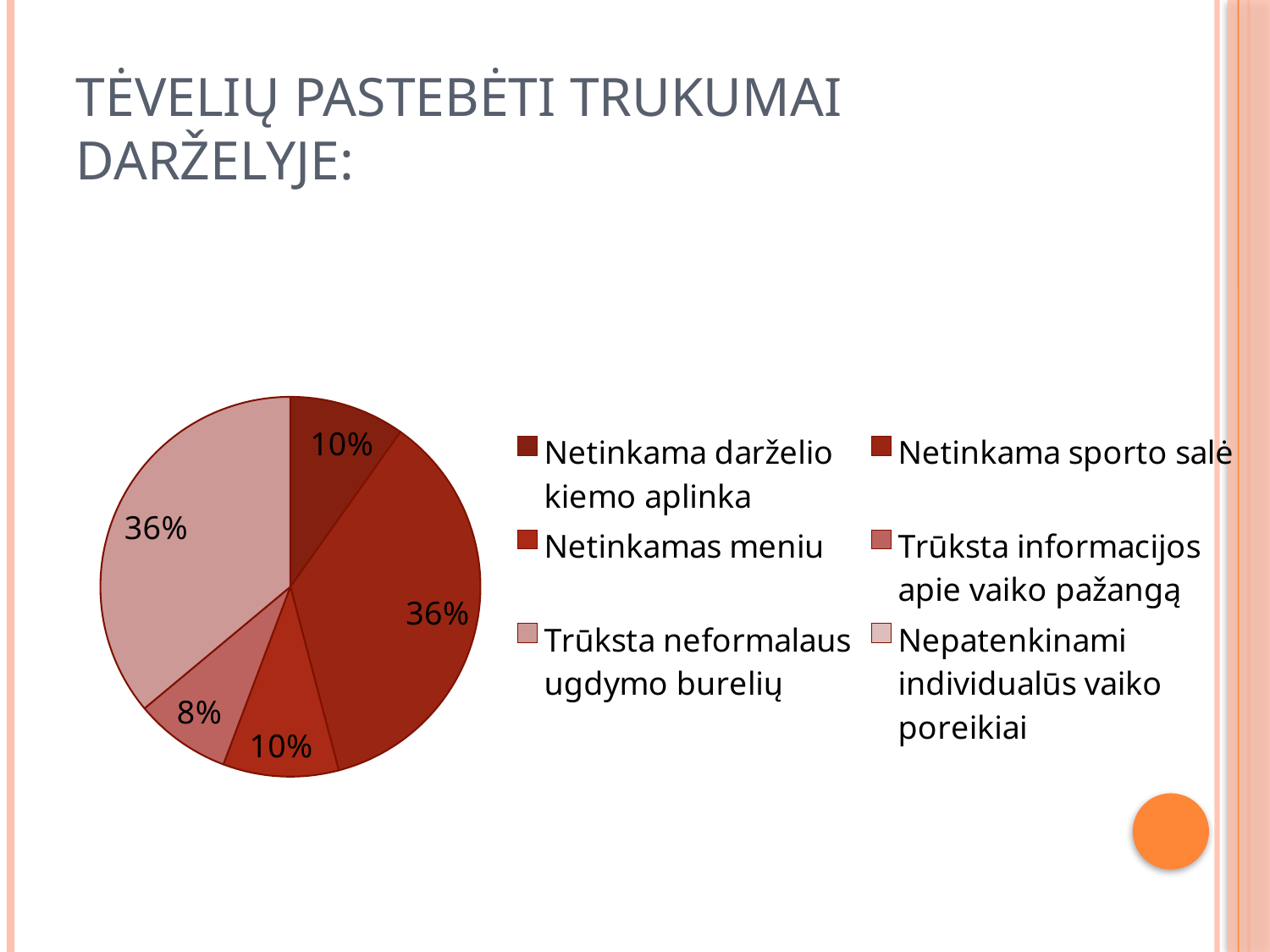
What percentage is shown for 'Netinkamas meniu'? 10% What is the difference between the share for 'Netinkama sporto salė' and the share for 'Netinkamas meniu'? 26% What percentage is shown for 'Trūksta informacijos apie vaiko pažangą'? 8% How many entries does the chart legend list? 6 What is the smallest percentage label printed on the pie? 8% Which is larger: the share for 'Netinkama sporto salė' or the share for 'Netinkama darželio kiemo aplinka'? Netinkama sporto salė How many percentage labels are printed on the pie slices? 5 What share of the pie is labelled for 'Netinkama sporto salė'? 36% What is the title of the slide containing the chart? TĖVELIŲ PASTEBĖTI TRUKUMAI DARŽELYJE: What is the largest percentage label printed on the pie? 36% What kind of chart is shown on the slide? pie chart What percentage is shown for 'Netinkama darželio kiemo aplinka'? 10%